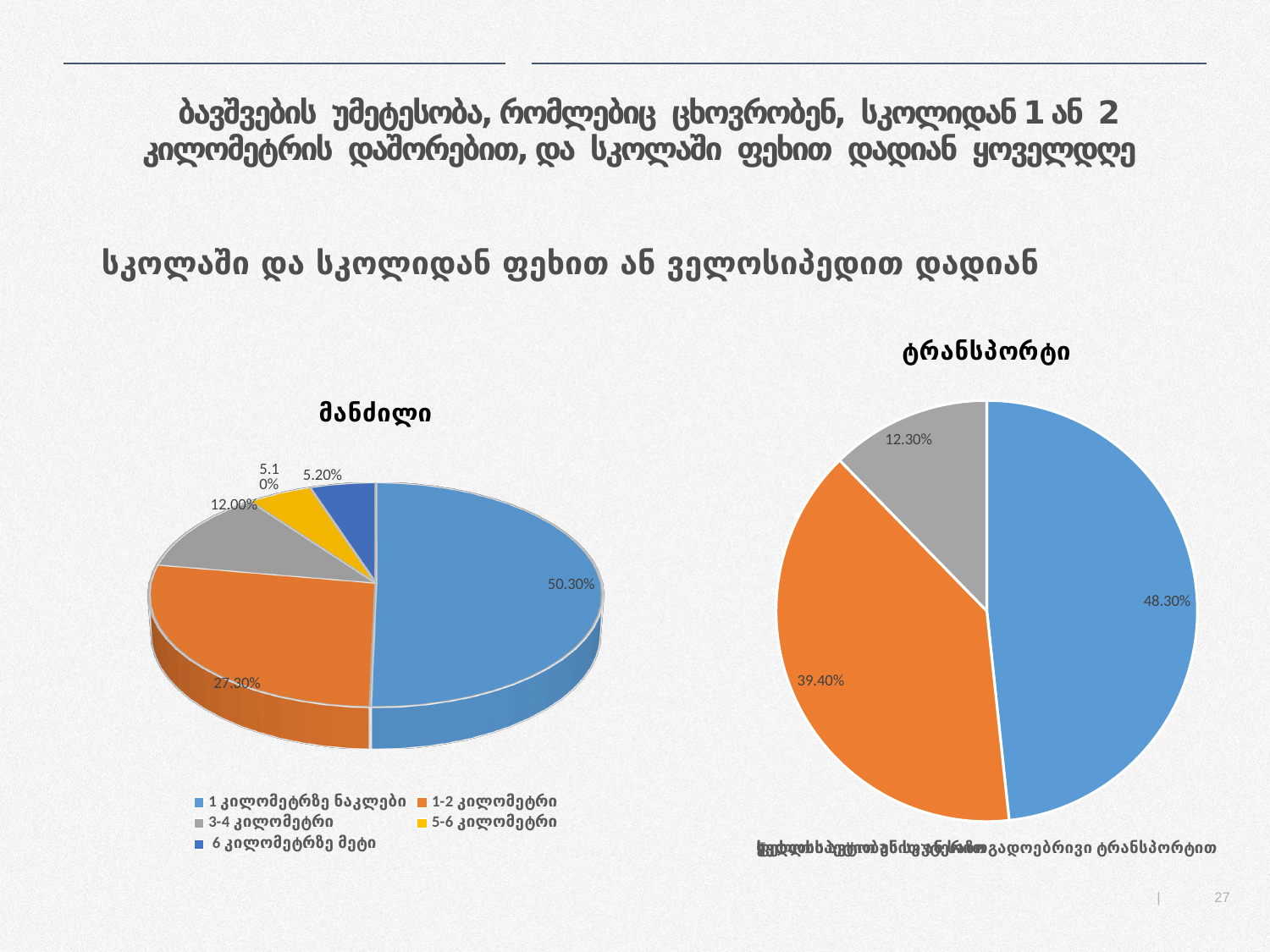
In the chart titled "ტრანსპორტი", what is the difference between the blue slice (48.30%) and the orange slice (39.40%)? 8.90% In the chart titled "მანძილი", what is the value for "3-4 კილომეტრი"? 12.00% In the chart titled "მანძილი", what is the difference between the values for "1 კილომეტრზე ნაკლები" and "1-2 კილომეტრი"? 23.00% In the chart titled "ტრანსპორტი", what is the value of the largest slice? 48.30% How many categories does the legend of the chart titled "მანძილი" list? 5 In the chart titled "მანძილი", what is the value for "1 კილომეტრზე ნაკლები"? 50.30% What kind of chart is the chart titled "მანძილი"? pie chart How many slices does the chart titled "ტრანსპორტი" have? 3 In the chart titled "მანძილი", what is the value for "1-2 კილომეტრი"? 27.30% In the chart titled "მანძილი", which category has the largest share? 1 კილომეტრზე ნაკლები In the chart titled "ტრანსპორტი", what is the value of the smallest slice? 12.30% In the chart titled "მანძილი", which is larger: "1-2 კილომეტრი" or "3-4 კილომეტრი"? 1-2 კილომეტრი